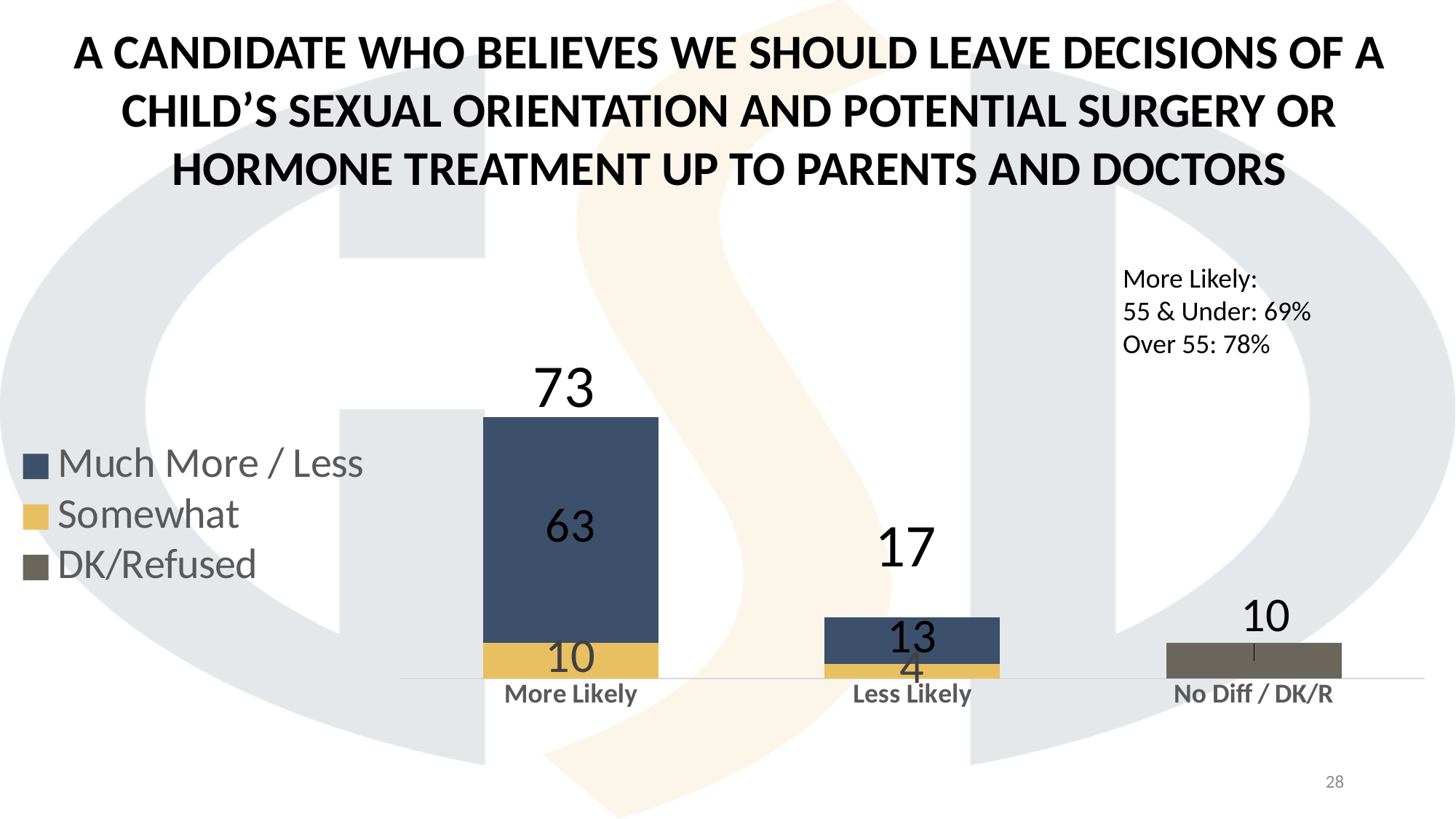
Which category has the highest total? More Likely What is the value shown for No Diff / DK/R? 10 Which is larger: the Somewhat segment for More Likely or the Somewhat segment for Less Likely? More Likely What is the value of the Somewhat segment for Less Likely? 4 How many categories are shown on the x axis? 3 Which category has the lowest total? No Diff / DK/R What is the total of the stacked bar for Less Likely? 17 How many series does the legend list? 3 What is the difference between the More Likely total and the Less Likely total? 56 What kind of chart is shown on the slide? Stacked bar chart What is the total of the stacked bar for More Likely? 73 What is the value of the Much More / Less segment for More Likely? 63